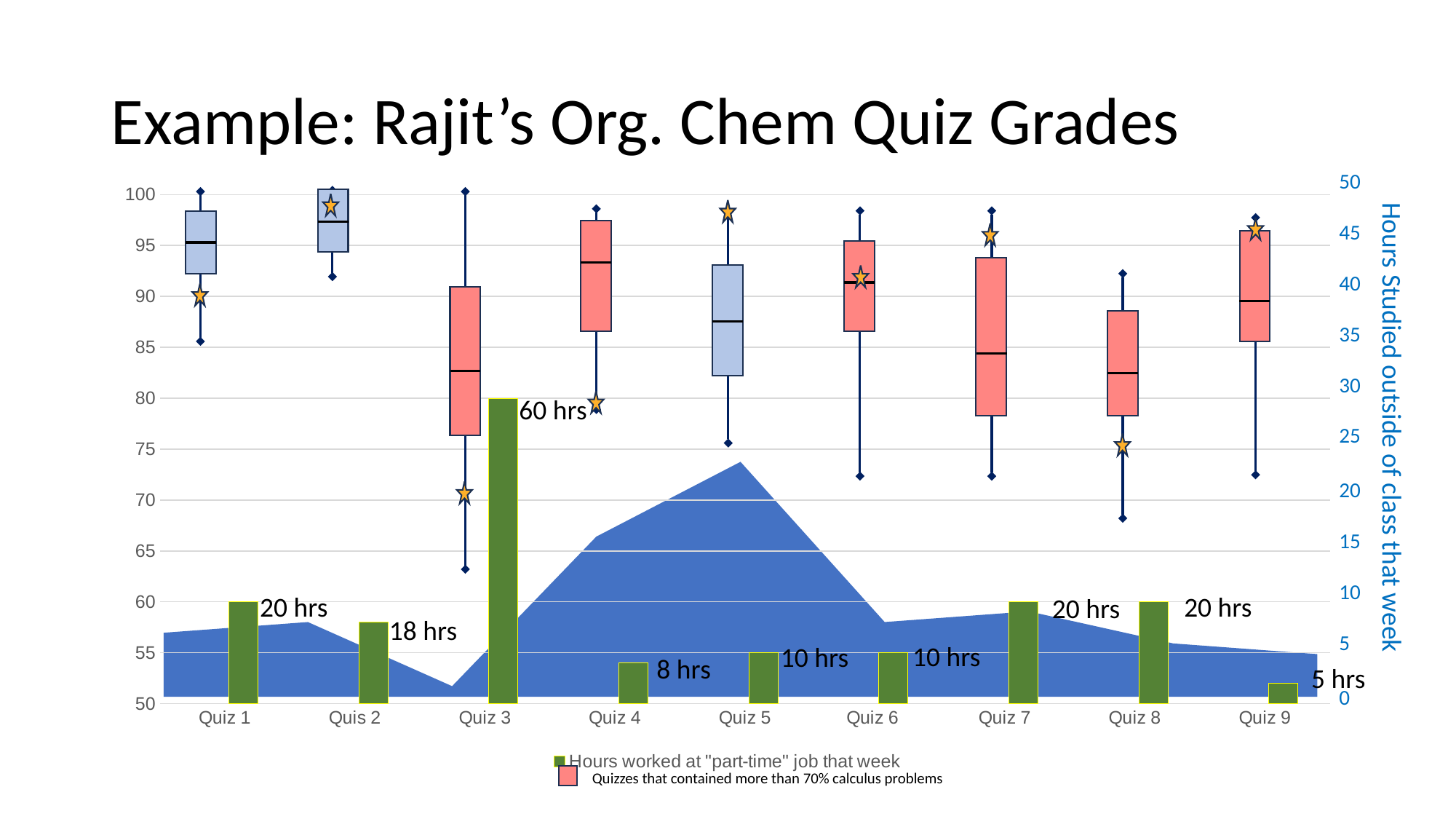
For which quiz week were the hours worked at the part-time job the lowest? Quiz 9 How many quizzes are shown along the x axis? 9 Which week had more hours worked at the part-time job, Quis 2 or Quiz 4? Quis 2 How many more hours did Rajit work at his part-time job in the week of Quiz 3 than in the week of Quiz 1? 40 hrs How many hours did Rajit work at his part-time job in the week of Quiz 3? 60 hrs Is the number of hours studied outside of class in the week of Quiz 3 greater or less than 5? less Is the number of hours studied outside of class in the week of Quiz 5 greater or less than 20? greater What kind of chart is used to show the hours worked at the part-time job? bar chart For which quiz week were the hours worked at the part-time job the highest? Quiz 3 How many hours did Rajit work at his part-time job in the week of Quiz 4? 8 hrs How many hours did Rajit work at his part-time job in the week of Quiz 9? 5 hrs What is the title of the right-hand vertical axis? Hours Studied outside of class that week